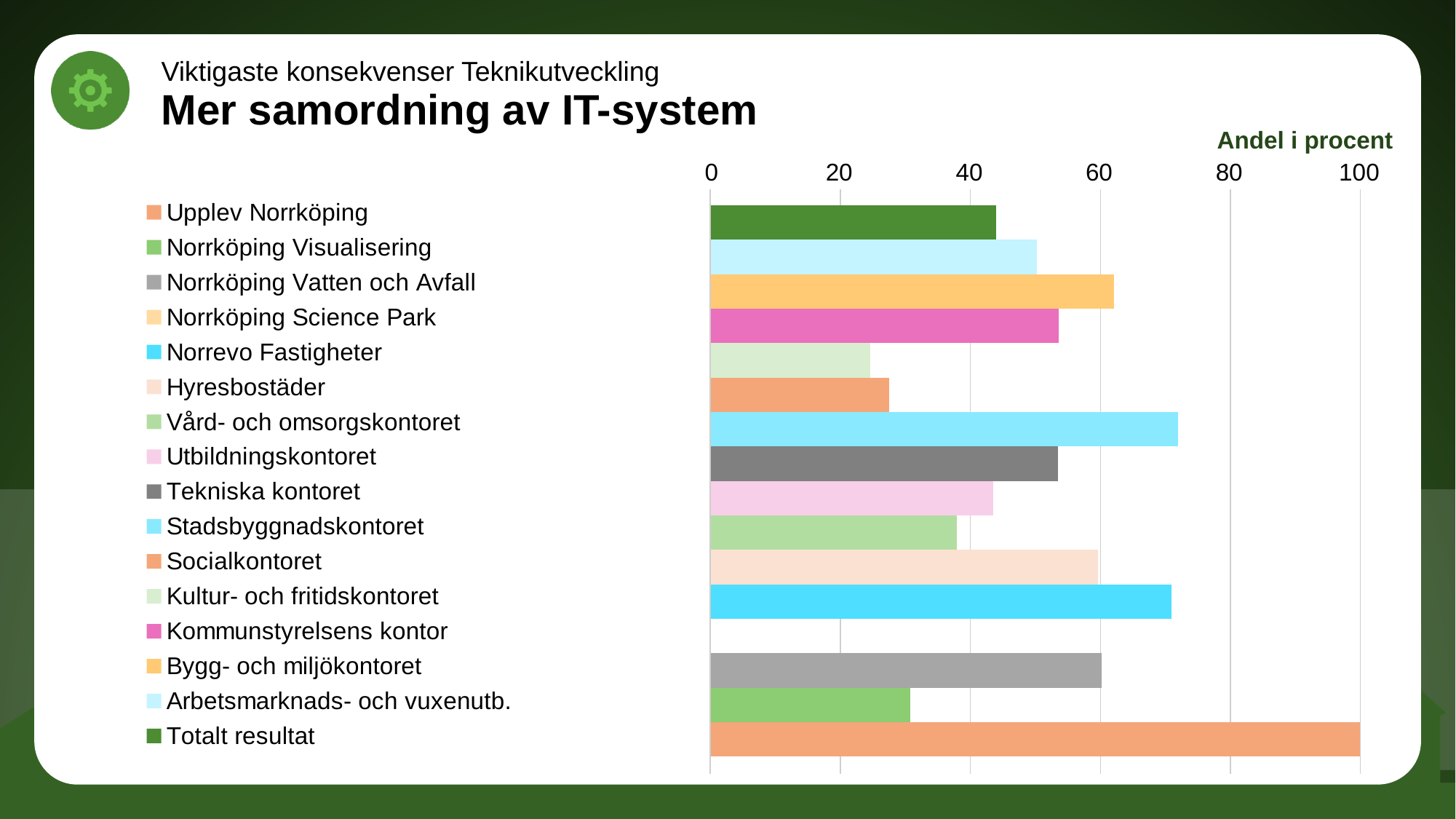
Is the value for Hyresbostäder greater or less than 80? less Is the value for Stadsbyggnadskontoret greater or less than 60? greater Which is larger, the value for Bygg- och miljökontoret or the value for Norrköping Visualisering? Bygg- och miljökontoret What is the label of the value axis on the chart? Andel i procent Which category has the highest value in the chart? Upplev Norrköping What is the title of the chart on the slide? Mer samordning av IT-system Which is larger, the value for Stadsbyggnadskontoret or the value for Socialkontoret? Stadsbyggnadskontoret Is the value for Kultur- och fritidskontoret greater or less than 40? less What kind of chart is shown on the slide? bar chart What is the value for Upplev Norrköping? 100 Which category has the lowest value (no visible bar) in the chart? Norrköping Science Park How many categories are listed in the chart's legend? 16